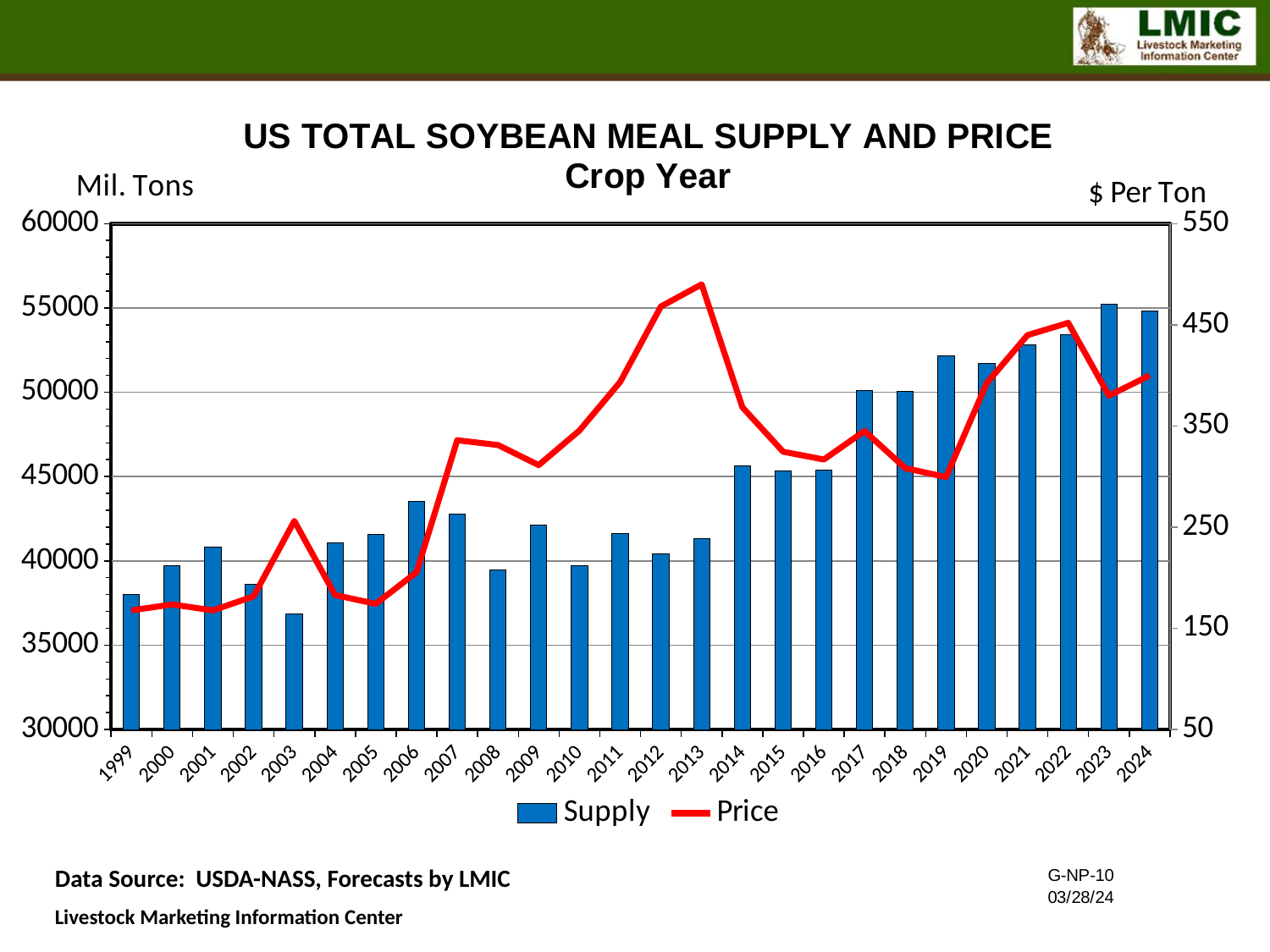
Is the Price value for 2013 greater or less than 450? greater Is the Supply value for 2003 greater or less than 40000? less Is the Price value for 1999 greater or less than 250? less What is the label on the right-hand vertical axis? $ Per Ton What kind of chart is shown on the slide? A combination bar and line chart Which crop year has the lowest Supply bar? 2003 Which crop year has the larger Supply bar, 2006 or 2008? 2006 Which crop year has the highest Supply bar? 2023 How many series does the legend list? 2 Does the Supply generally rise or fall from 2014 to 2023? rise How many crop years are shown on the x axis? 26 In which crop year does the Price line reach its highest point? 2013